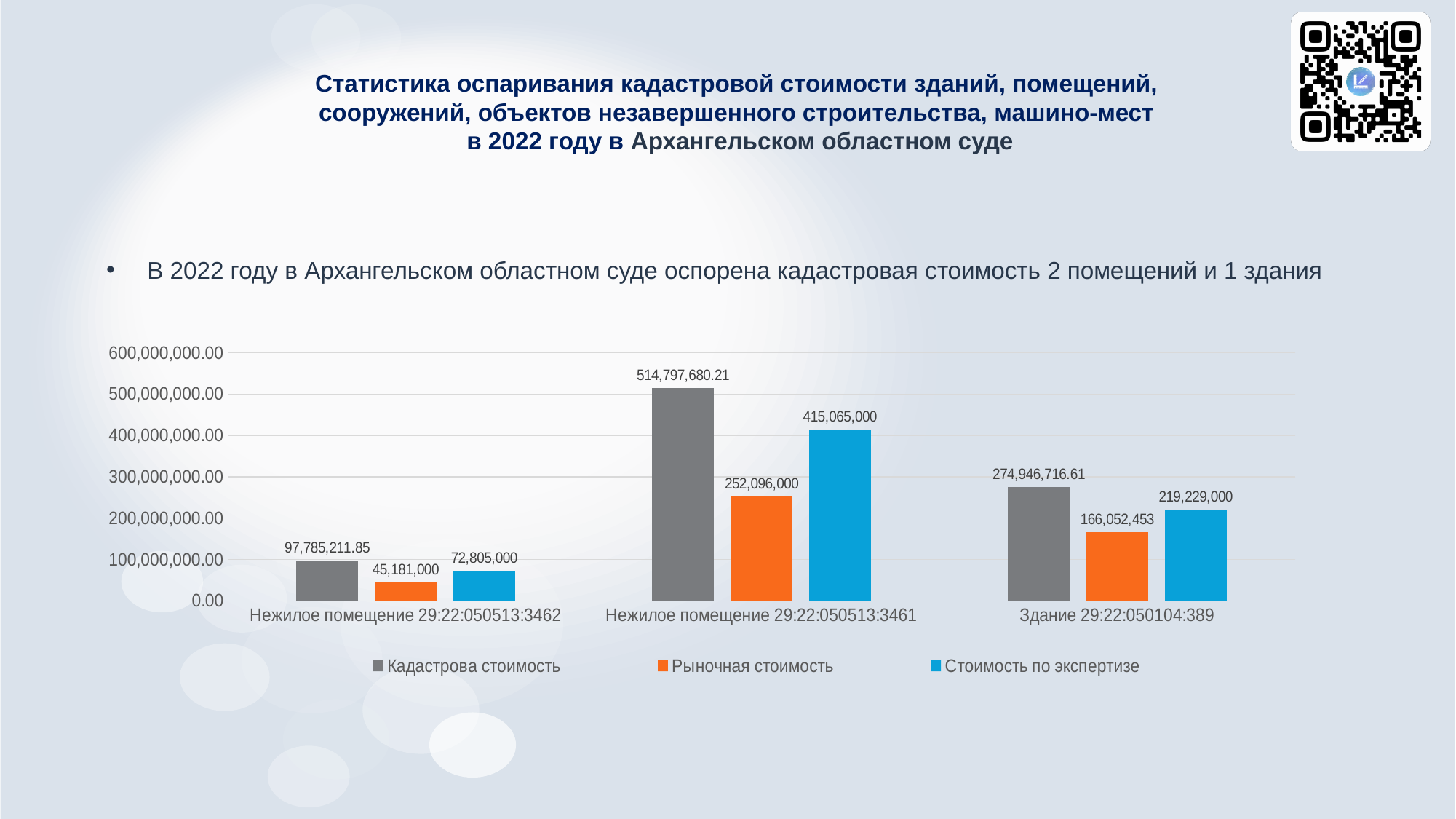
Is the Кадастрова стоимость for Нежилое помещение 29:22:050513:3461 greater or less than 500,000,000.00? greater How many series does the chart legend list? 3 Which category has the lowest Рыночная стоимость? Нежилое помещение 29:22:050513:3462 What type of chart is shown on the slide? bar chart How many categories are shown on the x axis of the chart? 3 What is the Стоимость по экспертизе value for Нежилое помещение 29:22:050513:3462? 72,805,000 What is the Кадастрова стоимость value for Нежилое помещение 29:22:050513:3461? 514,797,680.21 What is the difference between Стоимость по экспертизе and Рыночная стоимость for Здание 29:22:050104:389? 53,176,547 For Здание 29:22:050104:389, which is larger: Кадастрова стоимость or Стоимость по экспертизе? Кадастрова стоимость What is the Рыночная стоимость value for Здание 29:22:050104:389? 166,052,453 Which category has the highest Кадастрова стоимость? Нежилое помещение 29:22:050513:3461 What is the difference between Стоимость по экспертизе and Рыночная стоимость for Нежилое помещение 29:22:050513:3461? 162,969,000